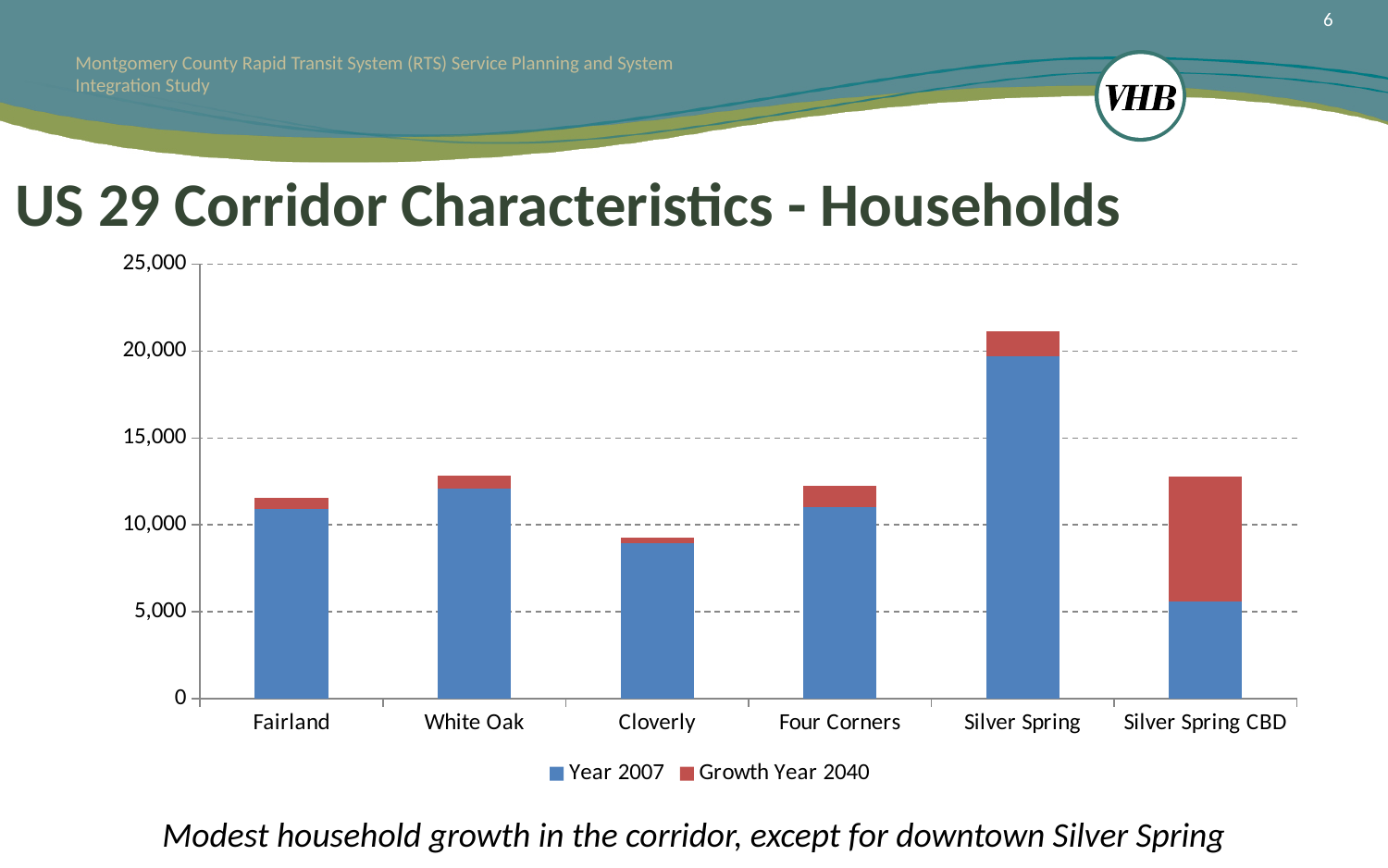
What is the title of the chart on the slide? US 29 Corridor Characteristics - Households Which category has the shortest stacked bar in the chart? Cloverly Which colour represents the Growth Year 2040 series in the chart? Red Is the Year 2007 value for Silver Spring CBD greater or less than 5,000? greater Which has the larger Growth Year 2040 segment, Silver Spring CBD or Fairland? Silver Spring CBD Which category has the tallest stacked bar in the chart? Silver Spring How many series does the chart legend list? 2 How many categories are shown on the x axis of the chart? 6 What kind of chart is shown on the slide? Stacked bar chart Which category has the largest Growth Year 2040 segment? Silver Spring CBD Is the total stacked value for Cloverly greater or less than 10,000? less Is the total stacked value for Silver Spring greater or less than 20,000? greater